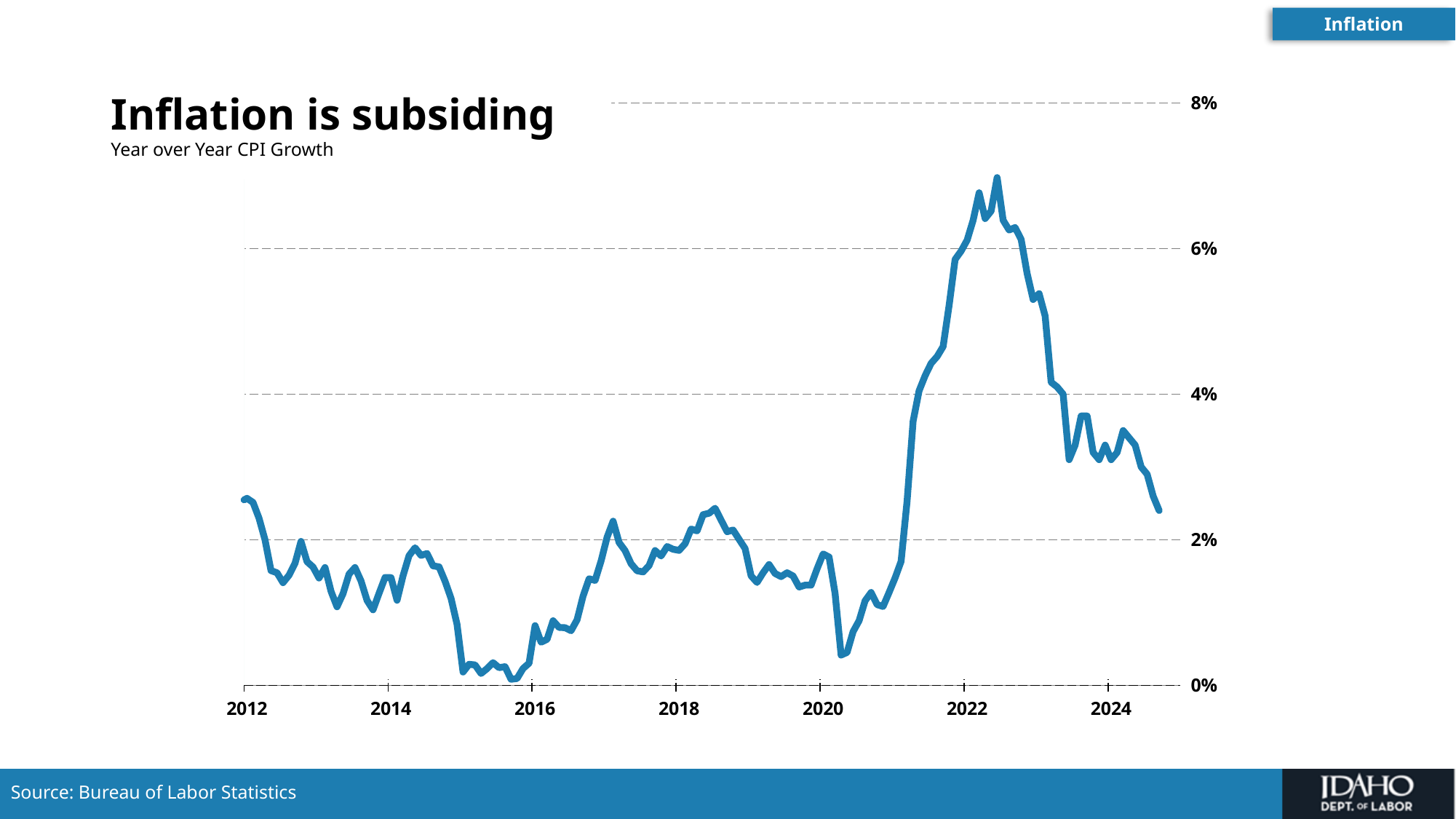
What kind of chart is shown on the slide? line chart What is the title of the chart? Inflation is subsiding Is the value at the end of the line in 2024 greater or less than 4%? less Does the line rise or fall between its 2022 peak and the end of 2024? fall How many year labels are shown on the x axis? 7 Around which year does the line reach its lowest point? 2015 Is the peak value of the line in 2022 greater or less than 6%? greater Is the value at the end of the line in 2024 greater or less than 2%? greater What does the subtitle say the chart measures? Year over Year CPI Growth In which year does the line reach its highest point? 2022